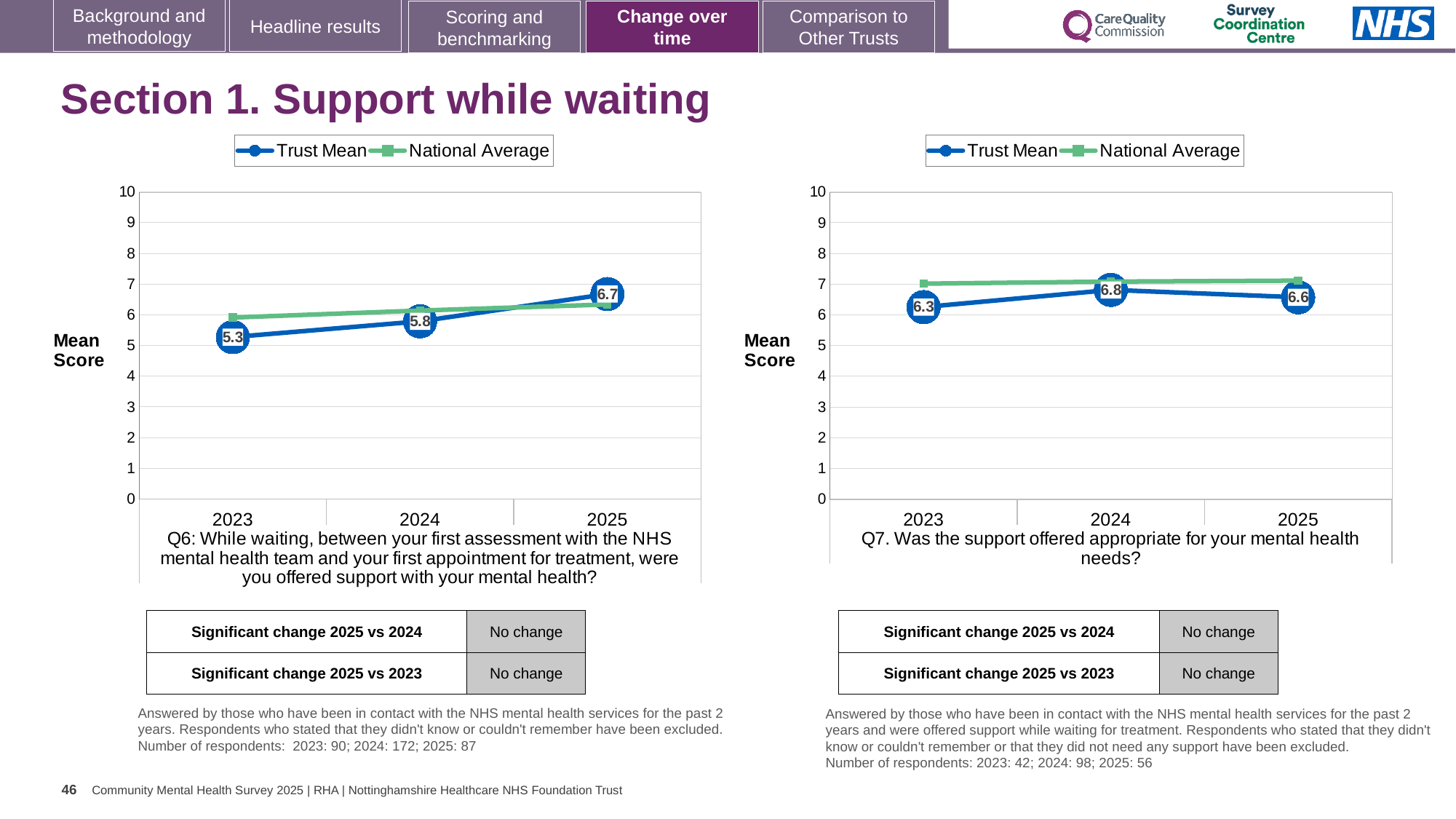
In the Q7 chart (right), which year has the highest Trust Mean score? 2024 In the Q6 chart (left), what is the Trust Mean score for 2025? 6.7 In the Q6 chart (left), what is the Trust Mean score for 2023? 5.3 In the Q7 chart (right), is the Trust Mean score for 2025 larger or smaller than the Trust Mean score for 2024? smaller In the Q7 chart (right), what is the Trust Mean score for 2024? 6.8 In the Q7 chart (right), is the National Average value for 2023 greater or less than 5? greater In the Q6 chart (left), which year has the lowest Trust Mean score? 2023 How many series does the legend of the Q7 chart (right) list? 2 How many years are plotted on the x axis of the Q6 chart (left)? 3 In the Q6 chart (left), does the Trust Mean rise or fall from 2023 to 2025? Rise In the Q6 chart (left), what is the difference between the Trust Mean scores for 2025 and 2023? 1.4 What type of chart is used for Q6 (left)? Line chart